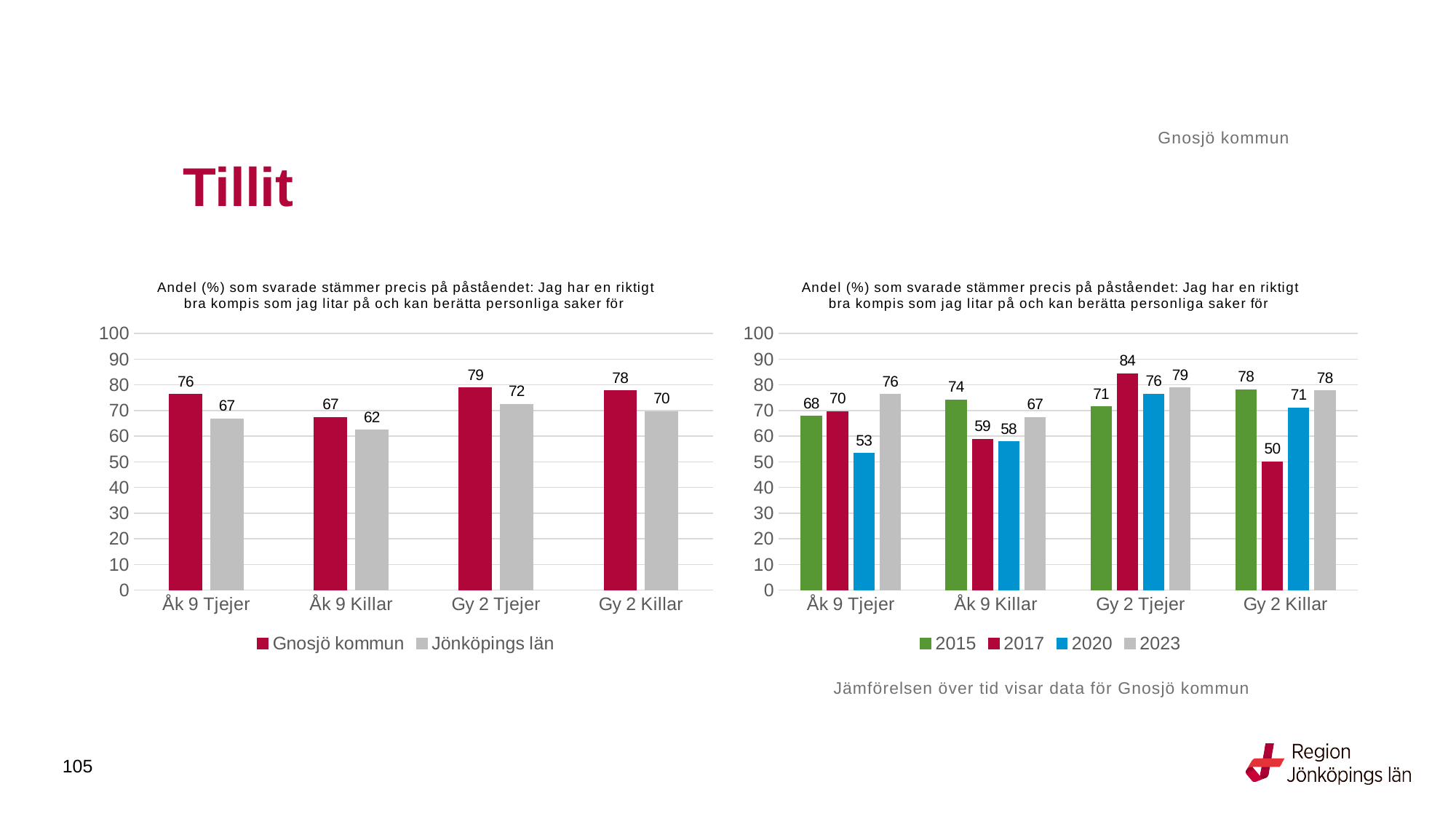
In the right chart, what is the difference between the 2023 and 2020 values for Åk 9 Tjejer? 23 In the left chart, which category has the highest value for Gnosjö kommun? Gy 2 Tjejer In the left chart, what is the value for Gnosjö kommun for Åk 9 Tjejer? 76 In the right chart, how many series does the legend list? 4 In the right chart, what is the value for 2017 for Gy 2 Tjejer? 84 What kind of chart is the right chart? Bar chart In the right chart, what is the value for 2020 for Åk 9 Tjejer? 53 In the left chart, how many series does the legend list? 2 In the left chart, what is the difference between Gnosjö kommun and Jönköpings län for Gy 2 Killar? 8 In the right chart, which is larger for Åk 9 Killar: the 2015 value or the 2023 value? 2015 In the left chart, what is the value for Jönköpings län for Åk 9 Killar? 62 In the right chart, which category has the lowest value for 2017? Gy 2 Killar